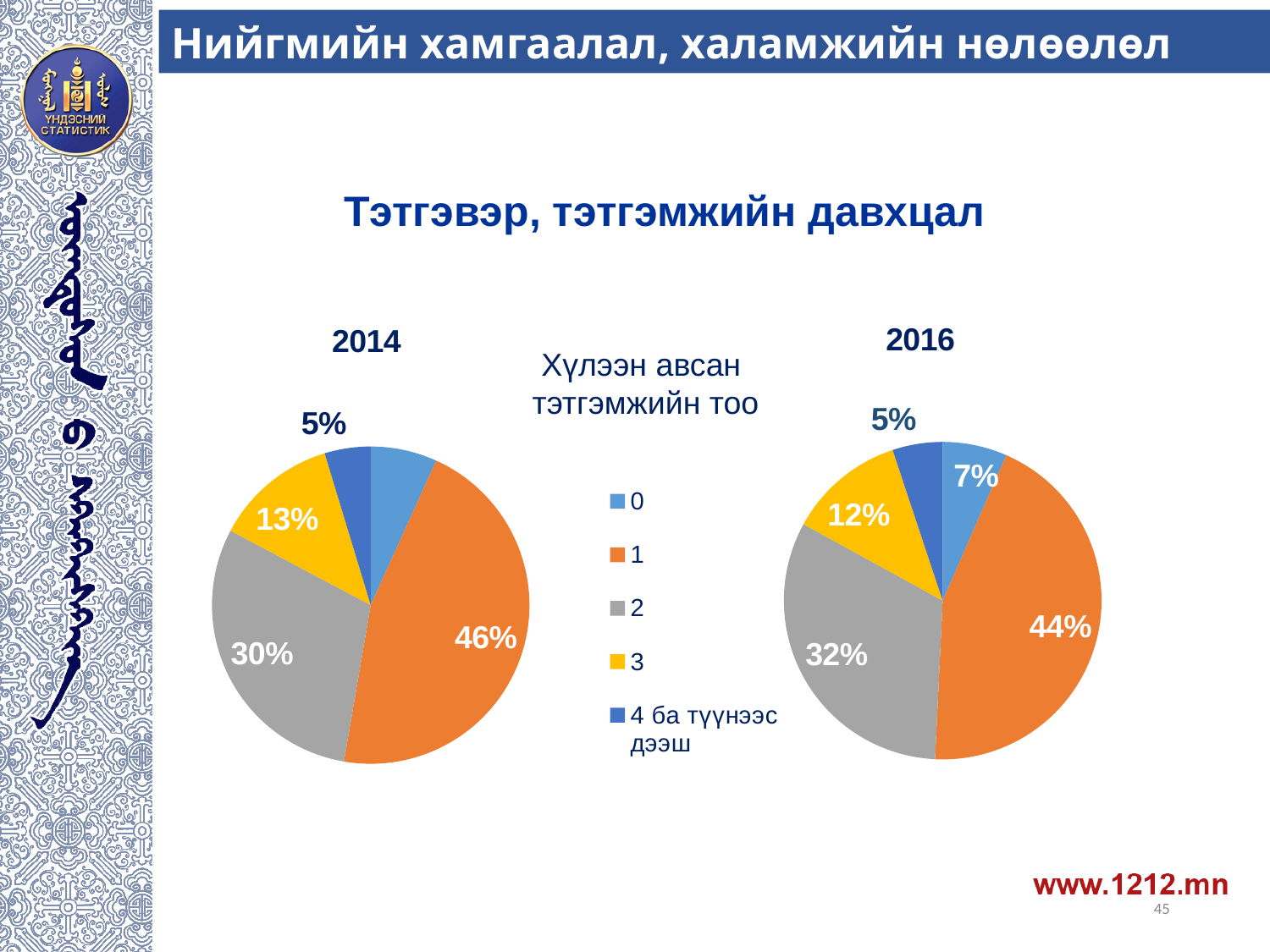
What is the difference between the share for category 1 in the 2014 pie chart and in the 2016 pie chart? 2 percentage points In the 2016 pie chart, what share is shown for category 0? 7% In the 2016 pie chart, which category has the largest slice? 1 In the 2016 pie chart, what share is shown for category 2? 32% What type of charts are shown on the slide? Pie charts In the 2014 pie chart, what share is shown for category 1? 46% In the 2016 pie chart, which category has the smallest slice? 4 ба түүнээс дээш In the 2014 pie chart, which is larger: the slice for category 2 or the slice for category 3? Category 2 In the 2014 pie chart, which category has the largest slice? 1 In the 2014 pie chart, what share is shown for category 3? 13% How many categories does the legend list for the pie charts? 5 In the 2016 pie chart, what share is shown for the category '4 ба түүнээс дээш'? 5%